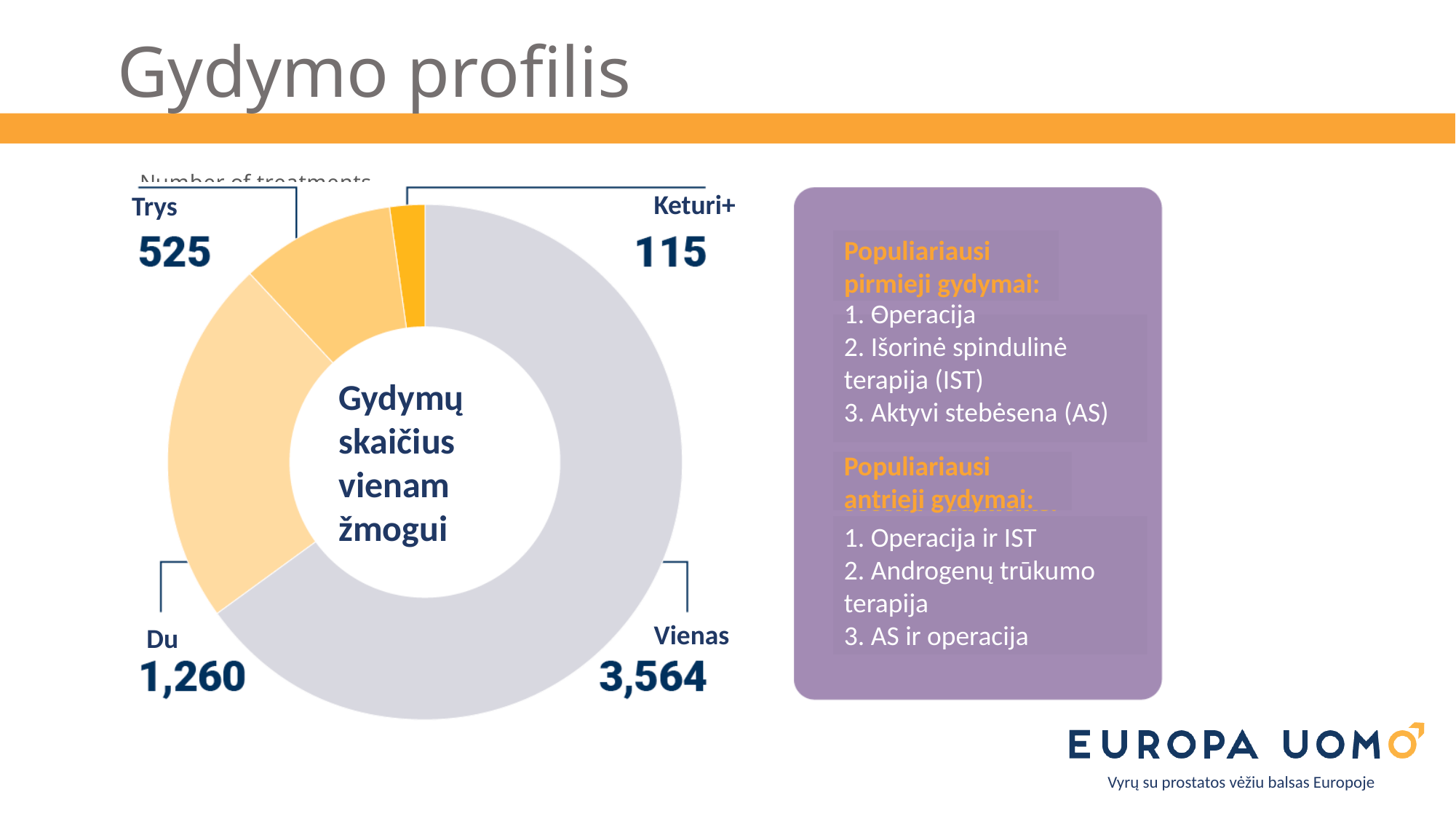
How many categories are shown in the donut chart? 4 Which is larger, the value for 'Du' or the value for 'Trys'? Du Which category has the smallest value in the donut chart? Keturi+ Which category has the largest value in the donut chart? Vienas What text is written in the centre of the donut chart? Gydymų skaičius vienam žmogui What is the value for the 'Trys' segment of the donut chart? 525 What kind of chart is shown on the slide? donut chart What is the value for the 'Du' segment of the donut chart? 1,260 What is the value for the 'Keturi+' segment of the donut chart? 115 What is the difference between the 'Trys' and 'Keturi+' values? 410 What is the value for the 'Vienas' segment of the donut chart? 3,564 What is the difference between the 'Vienas' and 'Du' values? 2,304